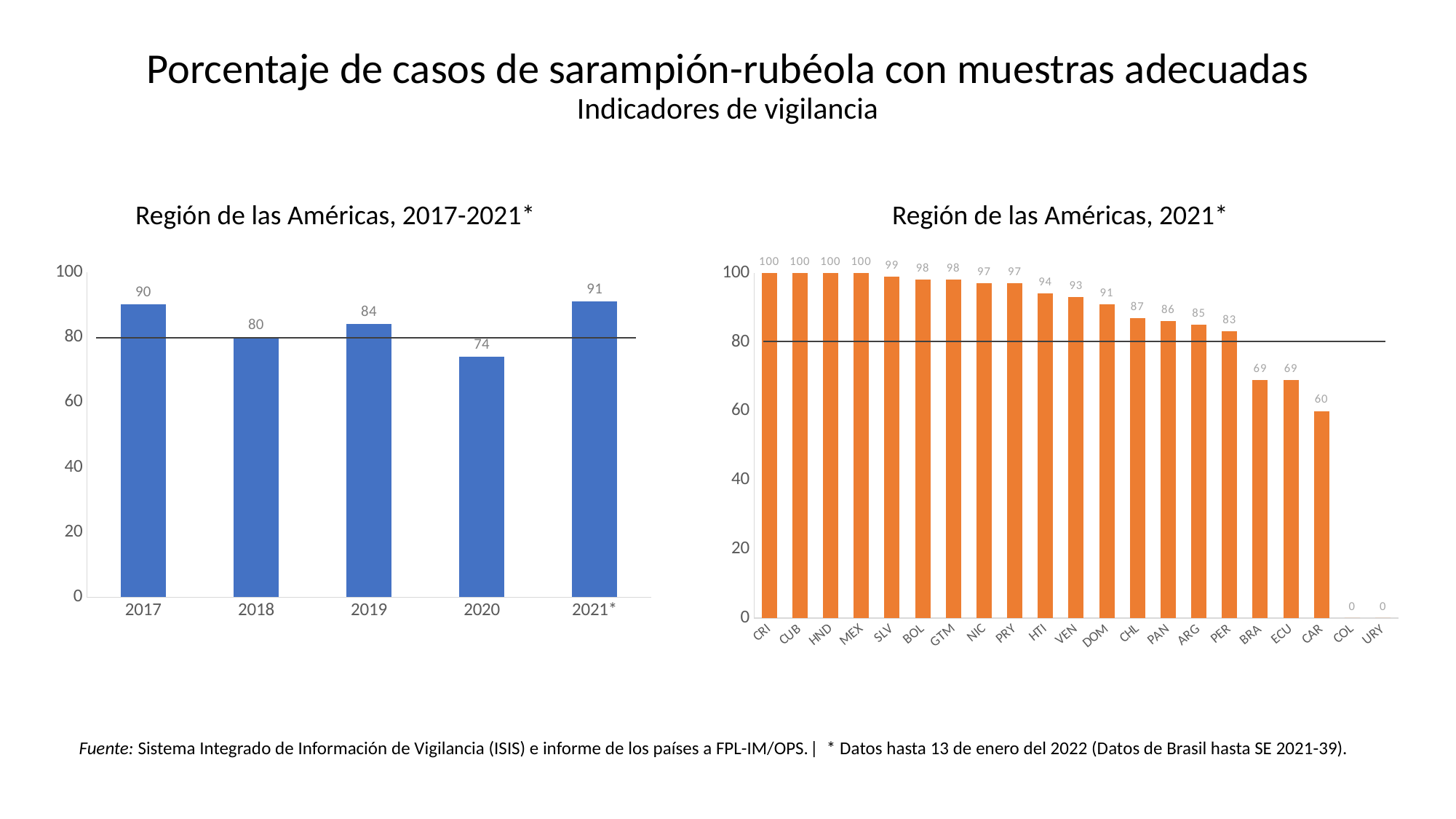
In the chart titled 'Región de las Américas, 2021*', what is the value for HTI? 94 In the chart titled 'Región de las Américas, 2017-2021*', what is the value for 2020? 74 What colour are the bars in the chart titled 'Región de las Américas, 2017-2021*'? Blue In the chart titled 'Región de las Américas, 2021*', which is larger, the value for CHL or the value for PER? CHL In the chart titled 'Región de las Américas, 2017-2021*', which year has the lowest value? 2020 What kind of chart is the one titled 'Región de las Américas, 2021*'? Bar chart In the chart titled 'Región de las Américas, 2017-2021*', which year has the highest value? 2021* In the chart titled 'Región de las Américas, 2021*', how many countries are listed on the x axis? 21 In the chart titled 'Región de las Américas, 2021*', what is the value for CAR? 60 In the chart titled 'Región de las Américas, 2017-2021*', how many years are shown on the x axis? 5 In the chart titled 'Región de las Américas, 2017-2021*', what is the difference between the values for 2017 and 2018? 10 In the chart titled 'Región de las Américas, 2021*', what is the difference between the values for SLV and BRA? 30